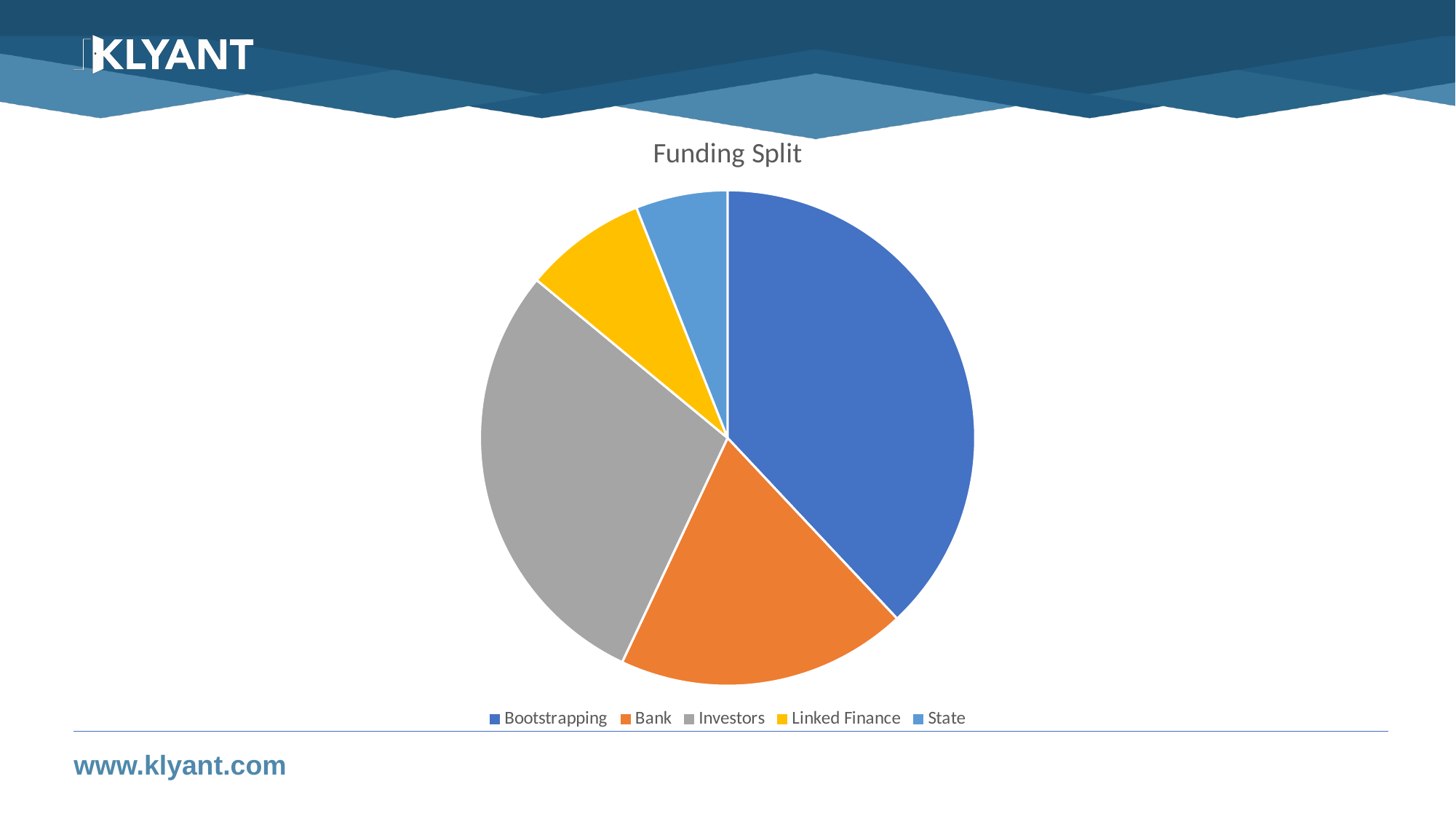
Which slice is larger, Bootstrapping or Investors? Bootstrapping What is the title of the chart? Funding Split Which slice is larger, State or Linked Finance? Linked Finance Which slice is larger, Linked Finance or Bank? Bank How many slices does the pie chart have? 5 Which category has the smallest slice of the pie? State What kind of chart is shown on the slide? pie chart Which category has the second-largest slice of the pie? Investors Which category is shown in grey in the pie chart? Investors Which category has the largest slice of the pie? Bootstrapping